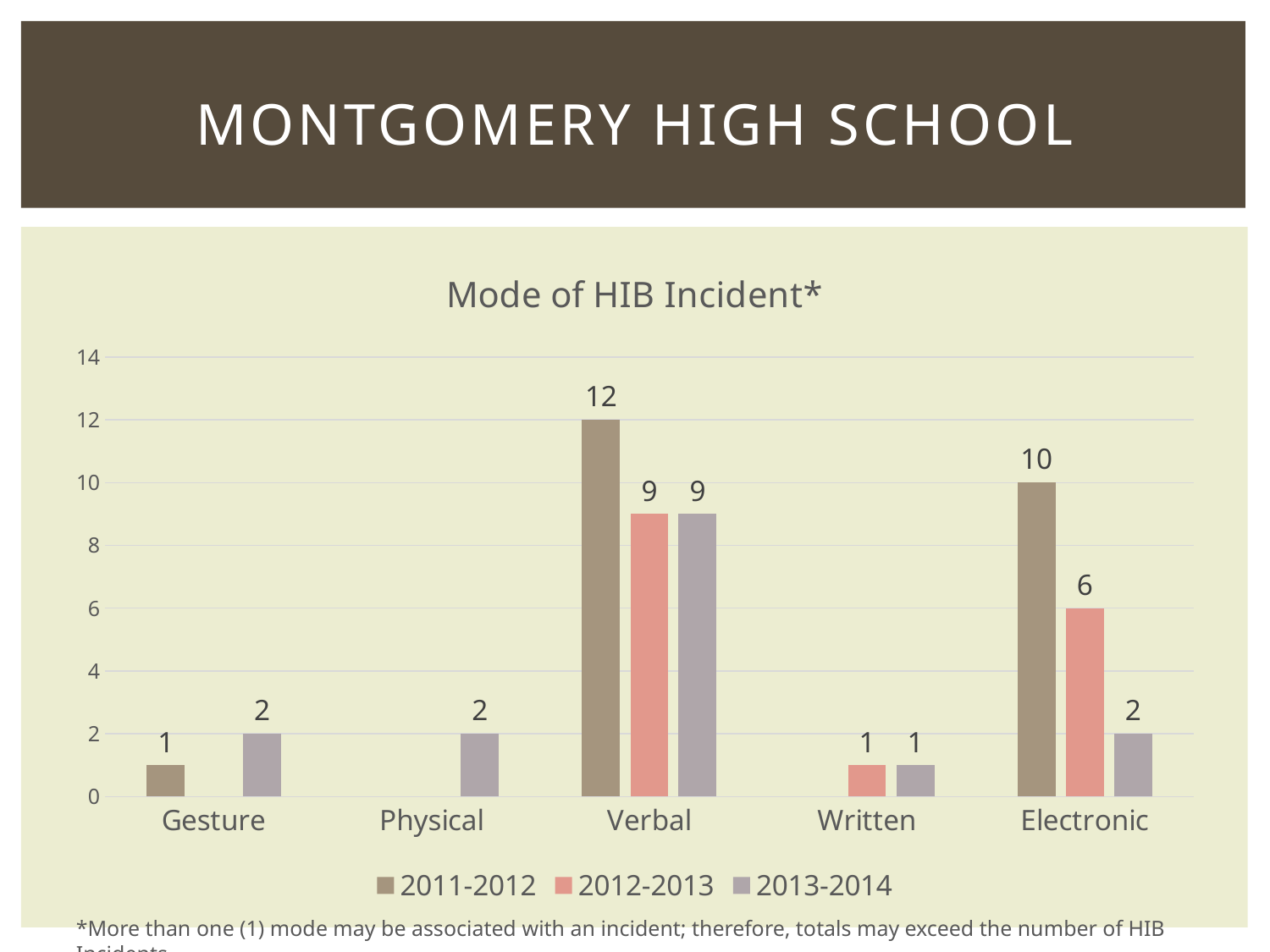
How many series does the legend list? 3 Which category has the highest value in the 2011-2012 series? Verbal Which is larger for Electronic: the 2011-2012 value or the 2013-2014 value? 2011-2012 What is the difference between the 2011-2012 and 2012-2013 values for Verbal? 3 Which category has the lowest value in the 2013-2014 series? Written What is the value for Verbal in the 2011-2012 series? 12 How many categories are shown on the x axis? 5 Is the 2011-2012 value for Electronic greater or less than 8? greater What is the title of the chart? Mode of HIB Incident* What is the value for Electronic in the 2012-2013 series? 6 What kind of chart is shown on the slide? bar chart What is the value for Gesture in the 2013-2014 series? 2